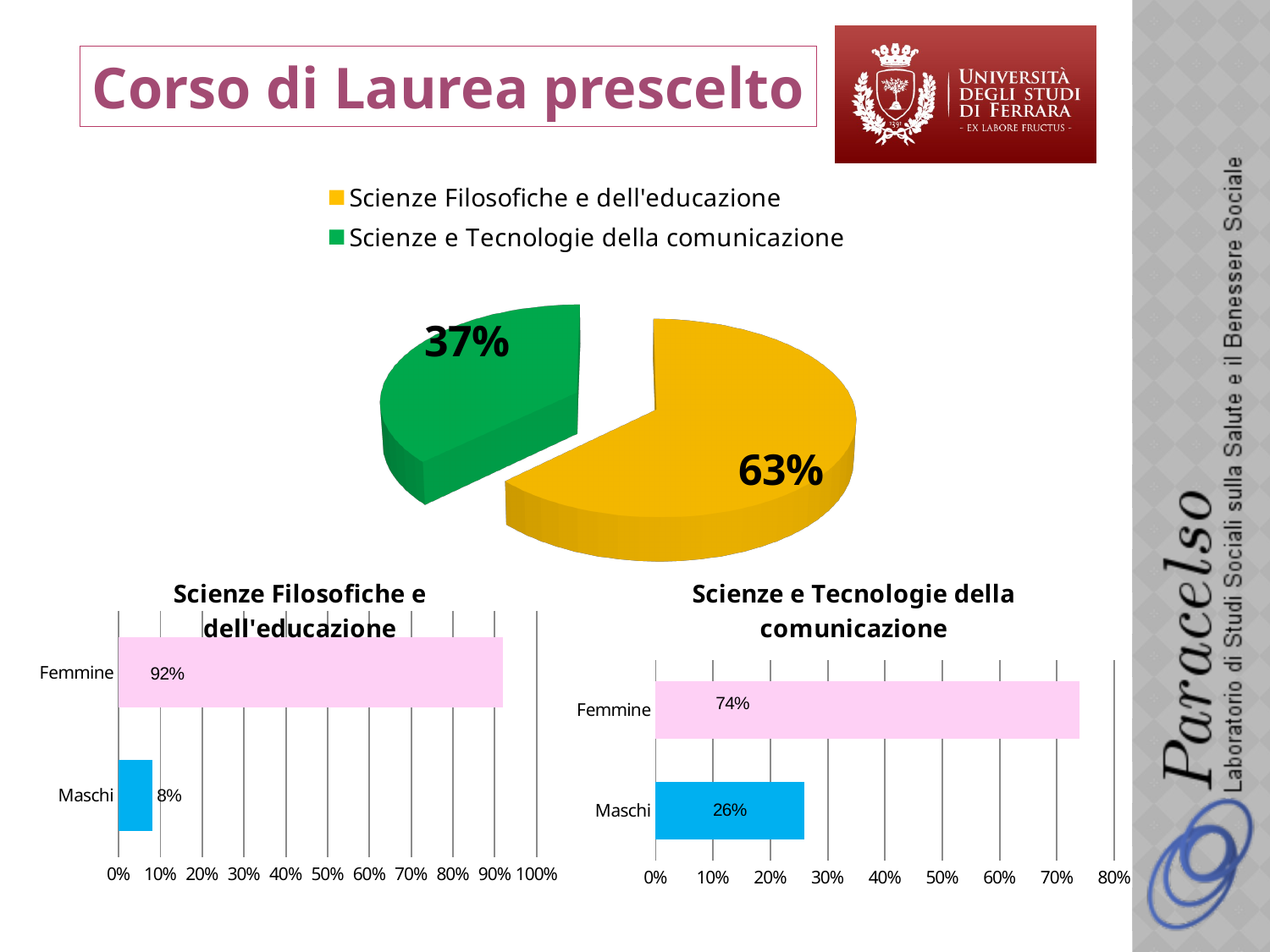
In the chart titled 'Scienze e Tecnologie della comunicazione', which category has the lowest value? Maschi How many entries does the legend of the pie chart at the top of the slide list? 2 In the chart titled 'Scienze Filosofiche e dell'educazione', what is the value for Maschi? 8% In the pie chart at the top of the slide, what share is shown for Scienze e Tecnologie della comunicazione? 37% In the chart titled 'Scienze Filosofiche e dell'educazione', what is the value for Femmine? 92% In the pie chart at the top of the slide, what colour is the slice for Scienze e Tecnologie della comunicazione? Green In the pie chart at the top of the slide, what share is shown for Scienze Filosofiche e dell'educazione? 63% What kind of chart is the one titled 'Scienze e Tecnologie della comunicazione'? Bar chart In the chart titled 'Scienze Filosofiche e dell'educazione', what is the difference between the Femmine and Maschi values? 84% In the pie chart at the top of the slide, which course has the larger slice? Scienze Filosofiche e dell'educazione In the chart titled 'Scienze e Tecnologie della comunicazione', what is the value for Femmine? 74% In the chart titled 'Scienze e Tecnologie della comunicazione', what is the value for Maschi? 26%